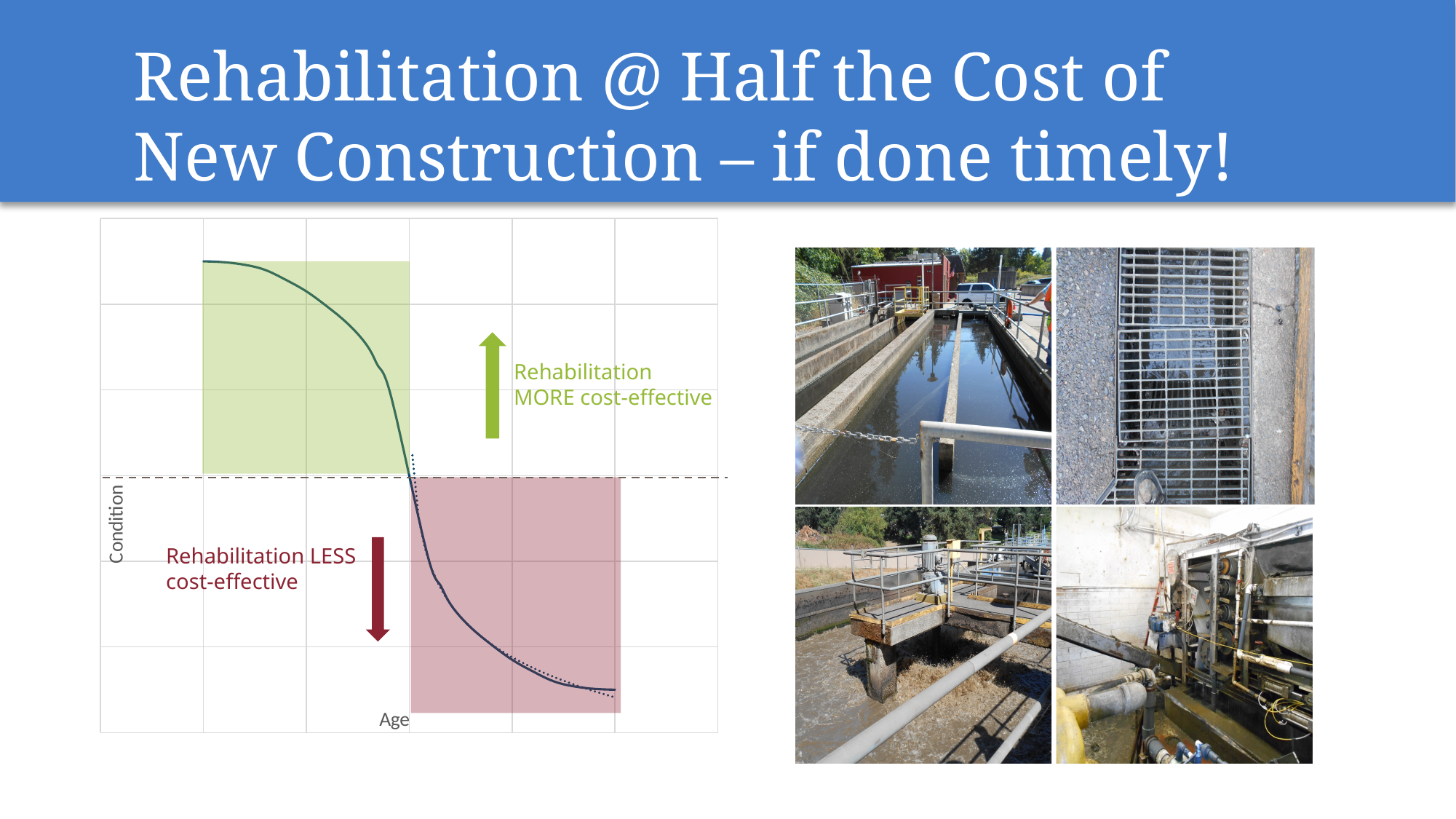
What kind of chart is shown on the left of the slide? Line chart Does the plotted condition curve rise or fall as age increases along the x axis? Fall What is the label of the horizontal axis of the chart? Age What is the label of the vertical axis of the chart? Condition